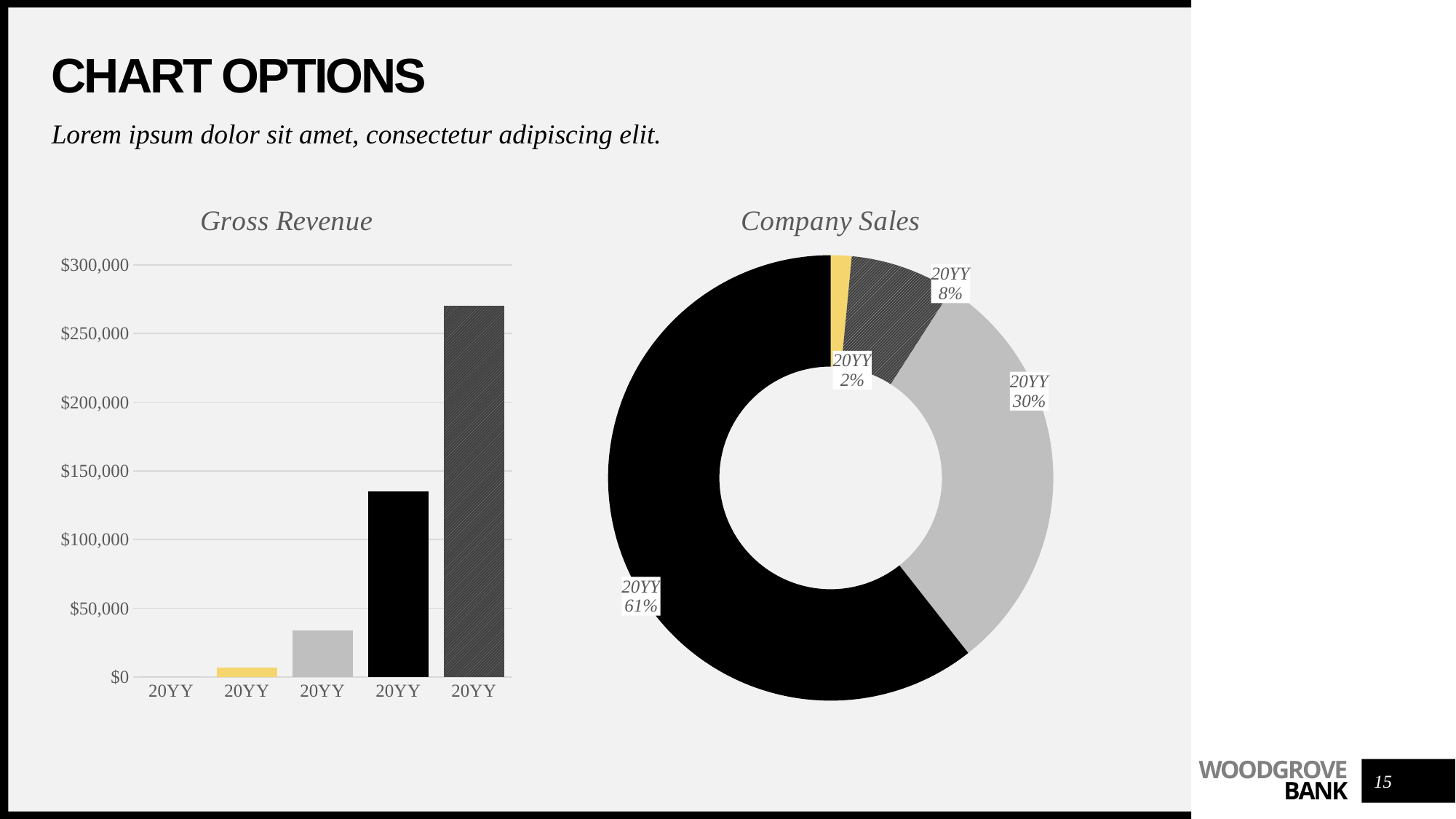
How many bars are plotted in the Gross Revenue chart? 4 What type of chart is the Company Sales chart on the right? doughnut chart In the Company Sales chart, what share does the largest (black) slice represent? 61% In the Gross Revenue chart, which bar is the tallest: the fourth or the fifth from the left? the fifth In the Gross Revenue chart, is the value of the third bar from the left greater or less than $50,000? less In the Gross Revenue chart, is the value of the tallest (rightmost) bar greater or less than $250,000? greater In the Company Sales chart, what share does the smallest (yellow) slice represent? 2% What type of chart is the Gross Revenue chart on the left? bar chart In the Company Sales chart, what is the difference in percentage points between the 61% slice and the 30% slice? 31 percentage points In the Gross Revenue chart, do the bar values rise or fall from left to right? rise How many slices does the Company Sales doughnut chart have? 4 In the Gross Revenue chart, is the value of the fourth bar from the left greater or less than $150,000? less